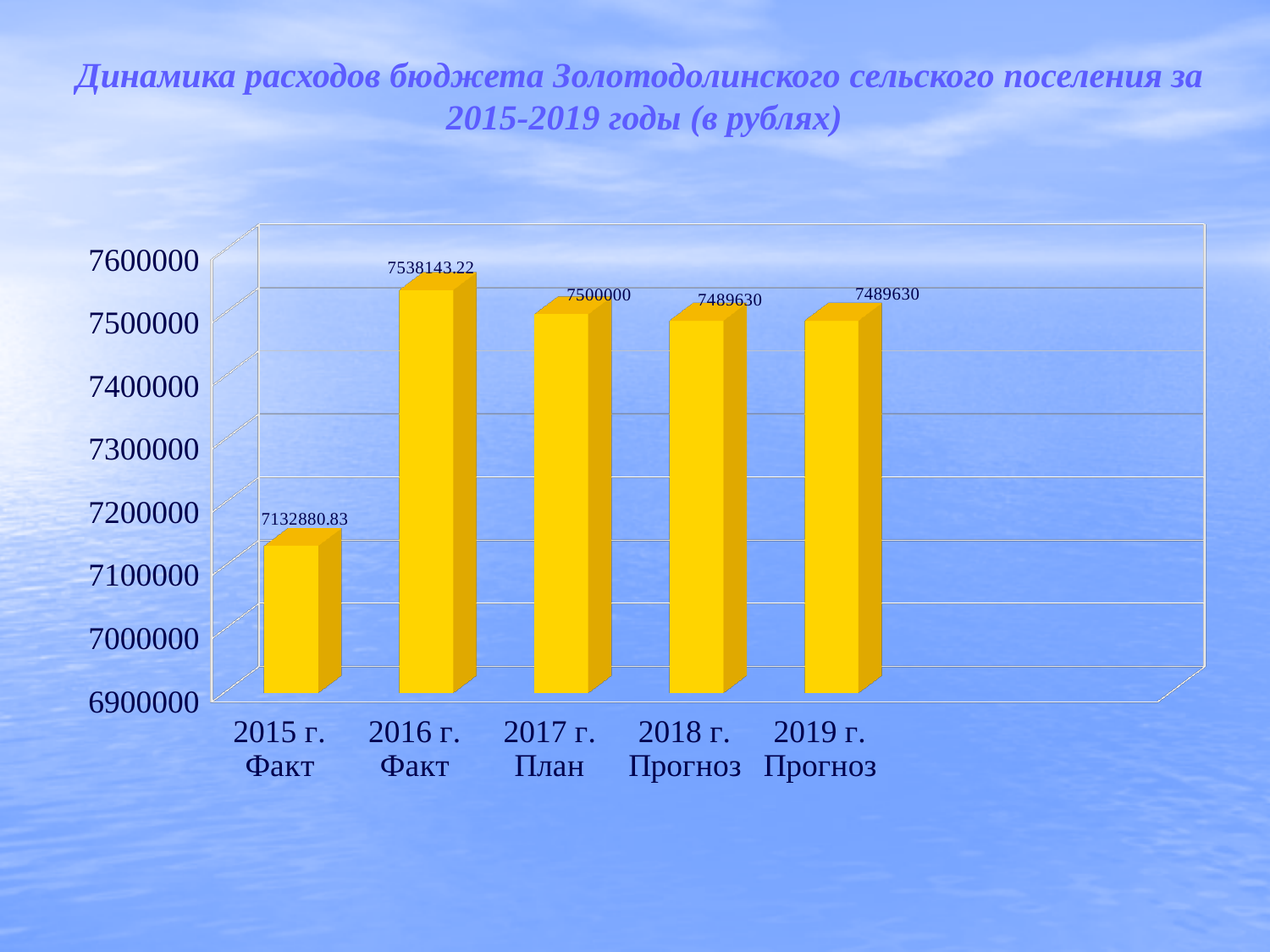
Which category has the lowest value? 2015 г. Факт What is the value for 2019 г. Прогноз? 7489630 What is the value for 2015 г. Факт? 7132880.83 From 2016 г. Факт to 2019 г. Прогноз, do the values rise or fall? fall What is the value for 2017 г. План? 7500000 What is the value for 2016 г. Факт? 7538143.22 What is the difference between the values for 2016 г. Факт and 2015 г. Факт? 405262.39 How many categories are shown on the x axis? 5 Which category has the highest value? 2016 г. Факт What kind of chart is shown on the slide? bar chart Which is larger, the value for 2016 г. Факт or 2017 г. План? 2016 г. Факт Is the value for 2015 г. Факт greater or less than 7200000? less